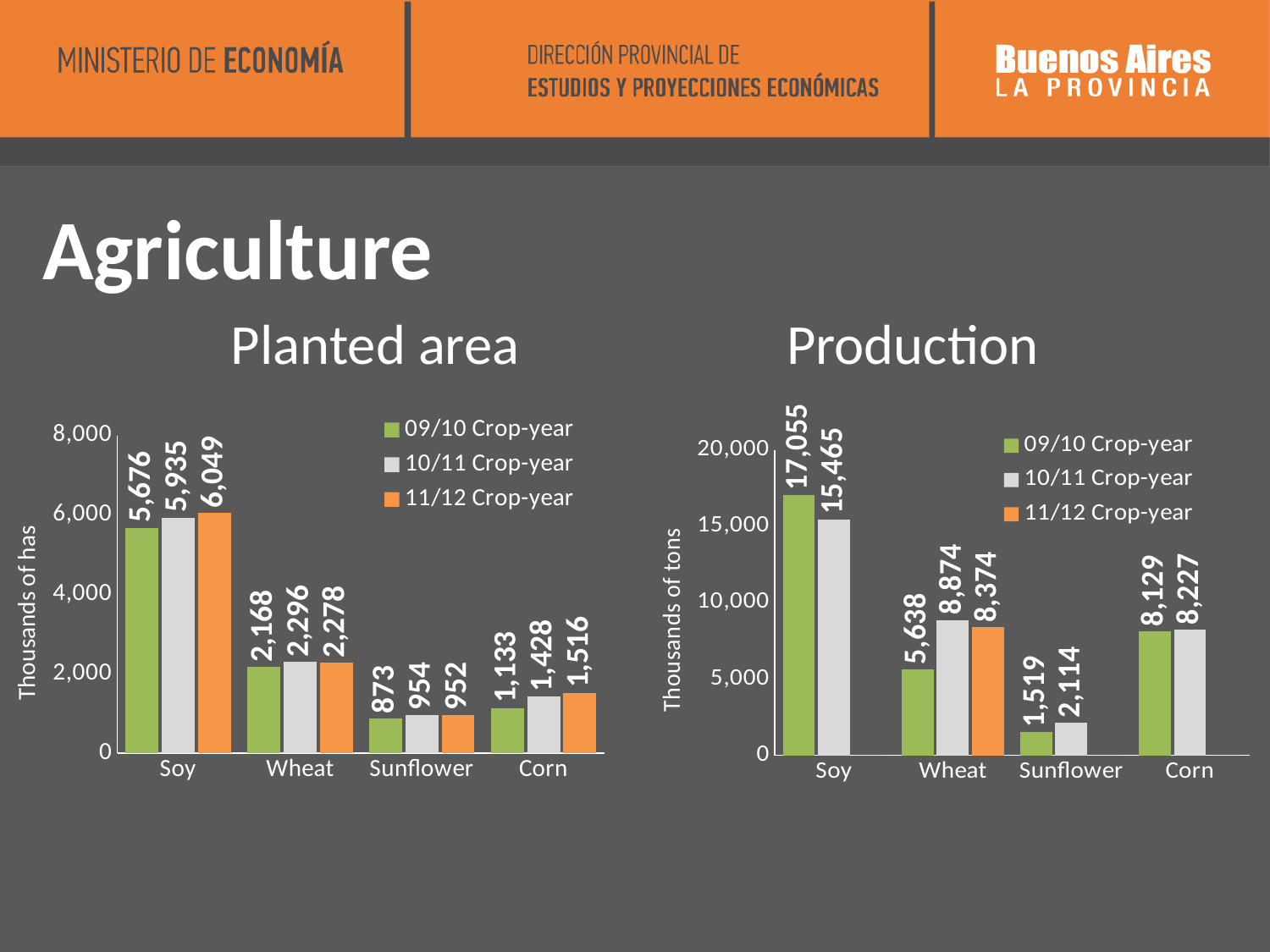
In the Production chart, which crop has the lowest production in the 09/10 Crop-year? Sunflower In the Planted area chart, what is the value for Soy in the 11/12 Crop-year? 6,049 How many crop categories are shown on the x axis of the Planted area chart? 4 In the Planted area chart, which crop has the highest planted area in the 10/11 Crop-year? Soy In the Production chart, what is the value for Wheat in the 10/11 Crop-year? 8,874 How many series does the legend of the Production chart list? 3 In the Planted area chart, which is larger for Wheat: the 10/11 Crop-year or the 11/12 Crop-year? 10/11 Crop-year In the Planted area chart, what is the value for Sunflower in the 09/10 Crop-year? 873 What type of chart is the Production chart? Bar chart In the Production chart, what is the difference between the Soy values for the 09/10 and 10/11 Crop-years? 1,590 In the Planted area chart, what is the difference between the Corn values for the 11/12 and 09/10 Crop-years? 383